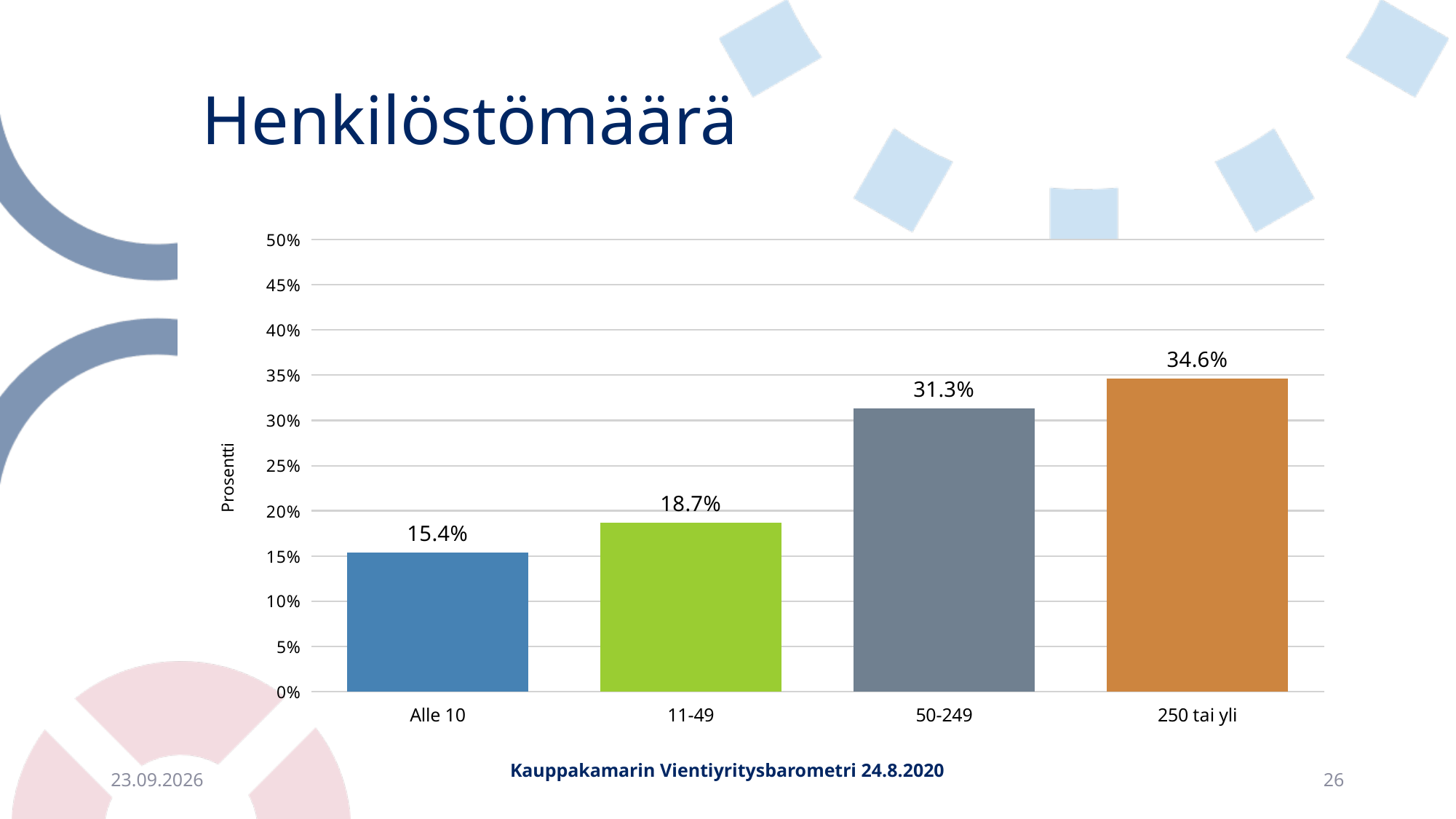
What is the difference between the values for "50-249" and "11-49"? 12.6% What kind of chart is shown on the slide? Bar chart How many categories are shown on the x axis? 4 Which category has the highest value? 250 tai yli What is the value for the "11-49" category? 18.7% Do the values rise or fall from left to right along the x axis? Rise What is the value for the "50-249" category? 31.3% Which category has the lowest value? Alle 10 What is the value for the "Alle 10" category? 15.4% What is the value for the "250 tai yli" category? 34.6% What is the difference between the values for "250 tai yli" and "Alle 10"? 19.2% Which is larger, the value for "11-49" or the value for "50-249"? 50-249